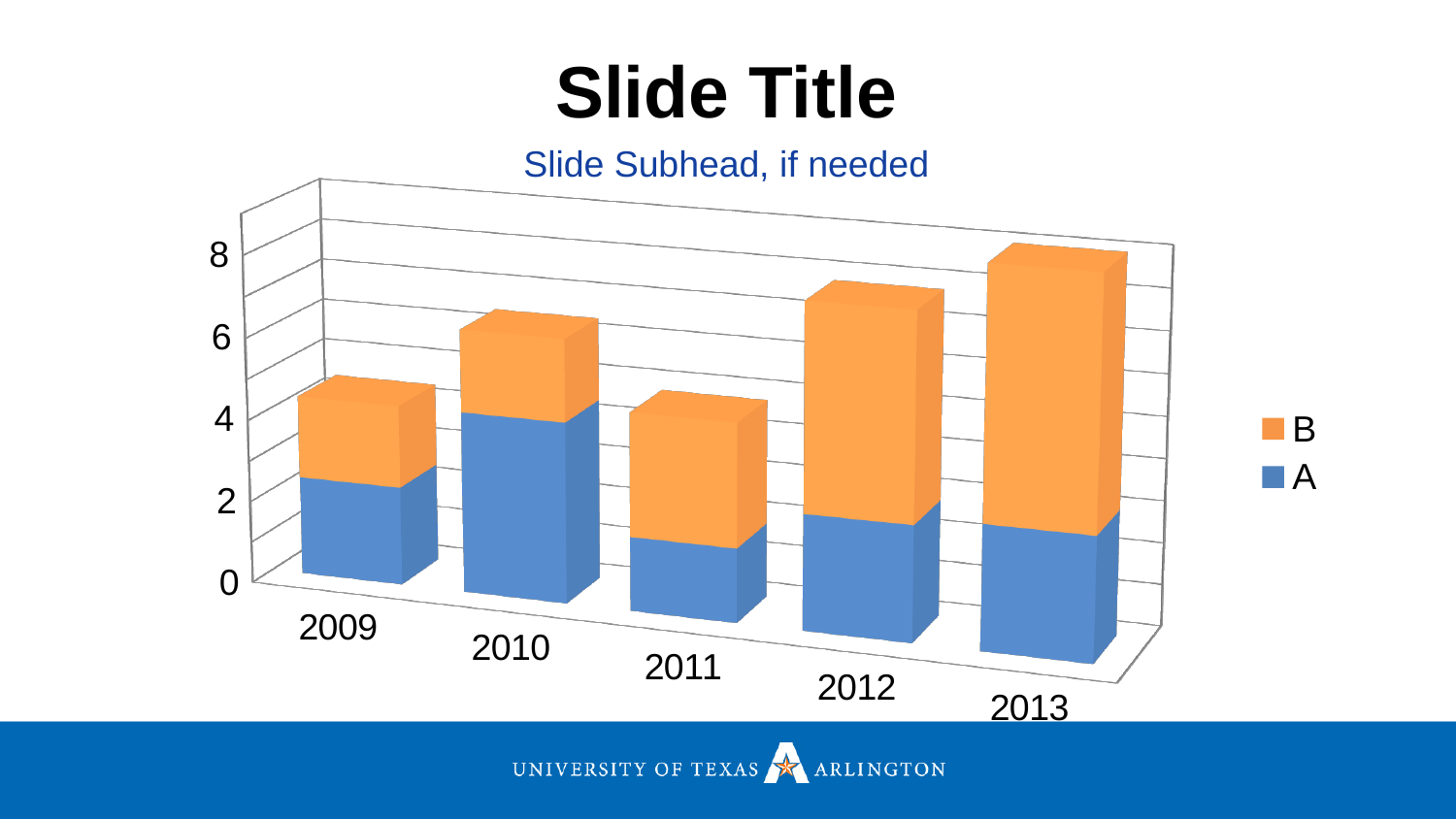
Which is larger: series A in 2010 or series A in 2011? series A in 2010 Is the value for series A in 2011 greater or less than 2? less Which year has the smallest value for series A? 2011 Which year has the largest value for series A? 2010 How many years are shown on the x axis of the chart? 5 Which year has the tallest stacked bar overall? 2013 Which is larger: series B in 2013 or series B in 2009? series B in 2013 What colour represents series A in the chart? blue Is the total stacked value for 2013 greater or less than 6? greater How many series does the chart's legend list? 2 What kind of chart is shown on the slide? bar chart Which year has the largest value for series B? 2013